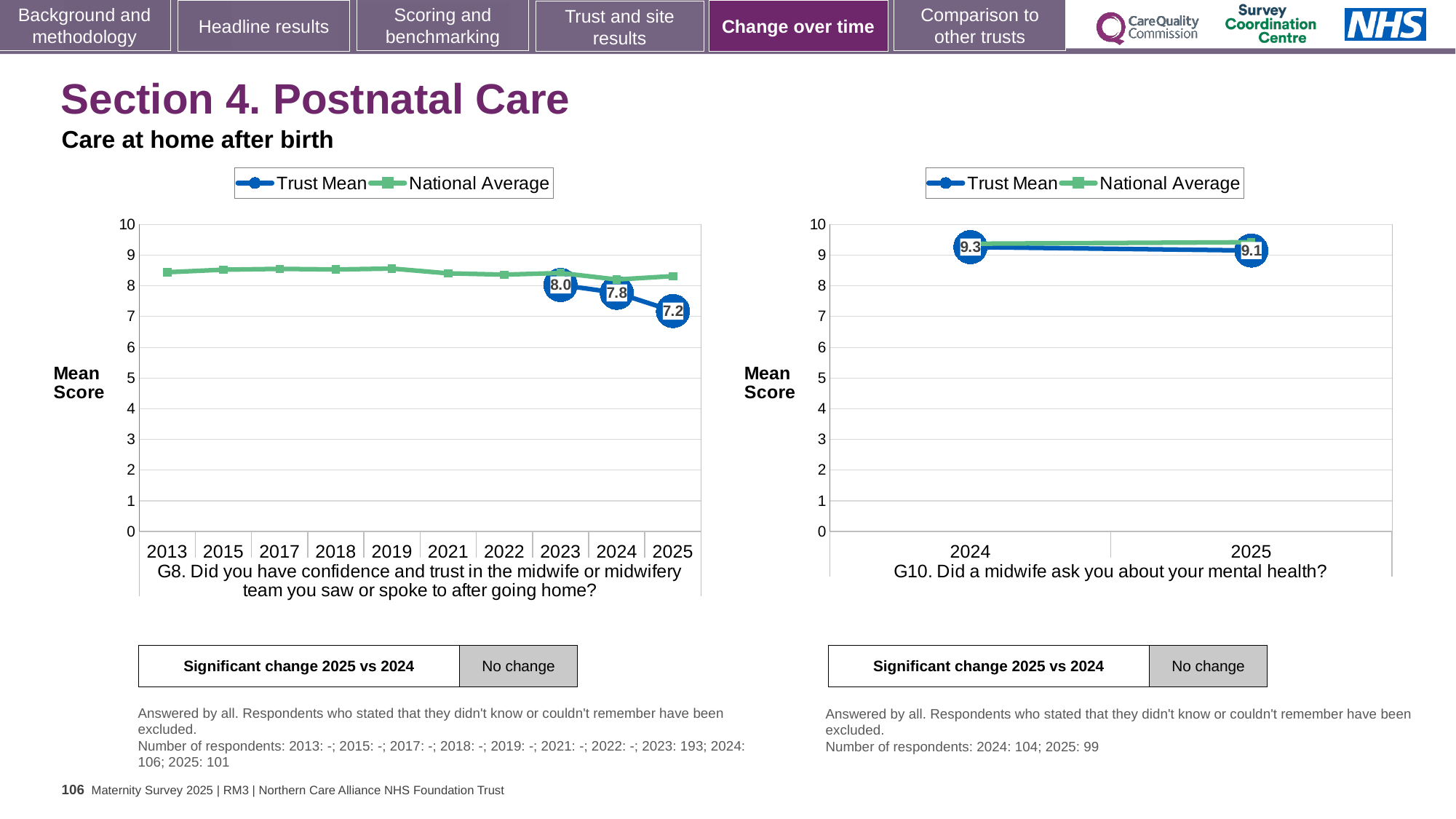
In the G10 chart on the right, what is the Trust Mean for 2025? 9.1 In the G8 chart on the left, what is the Trust Mean for 2025? 7.2 How many series does the legend of the G10 chart on the right list? 2 How many years are shown on the x axis of the G8 chart on the left? 10 In the G8 chart on the left, which year has the lowest Trust Mean? 2025 In the G10 chart on the right, what is the difference between the Trust Mean in 2024 and in 2025? 0.2 In the G8 chart on the left, what is the difference between the Trust Mean in 2023 and in 2025? 0.8 In the G8 chart on the left, is the National Average for 2013 greater or less than 8? greater In the G8 chart on the left, what is the Trust Mean for 2023? 8.0 In the G8 chart on the left, does the Trust Mean rise or fall from 2023 to 2025? fall In the G8 chart on the left, is the Trust Mean for 2024 larger or smaller than the Trust Mean for 2025? larger In the G10 chart on the right, what is the Trust Mean for 2024? 9.3